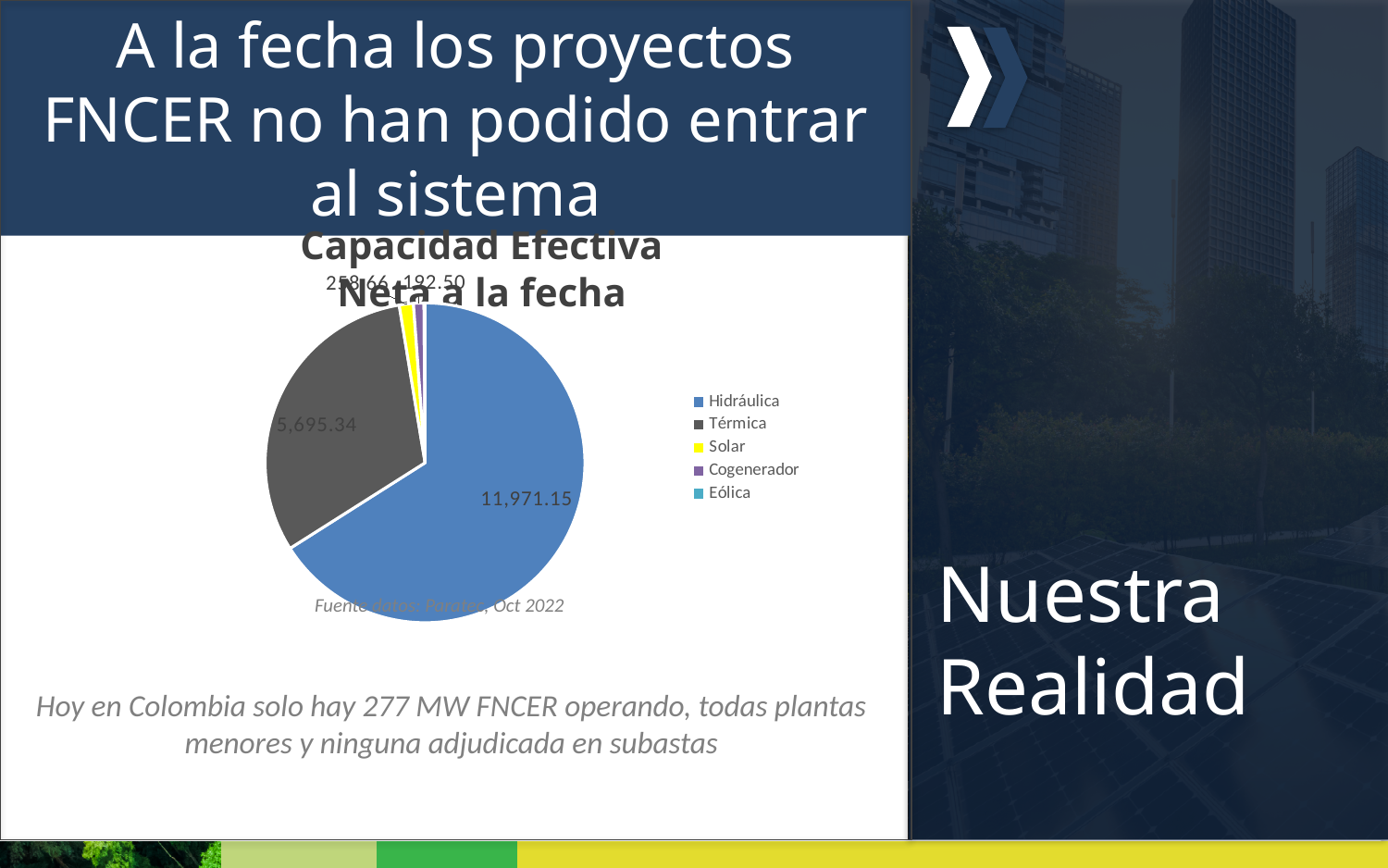
Which is larger in the pie chart, Hidráulica or Térmica? Hidráulica Which category has the largest slice in the pie chart? Hidráulica What is the title of the pie chart? Capacidad Efectiva Neta a la fecha Is the value for Hidráulica in the pie chart greater or less than 10,000? greater What kind of chart is shown on the slide? pie chart Which is larger in the pie chart, Solar or Térmica? Térmica What is the difference between the Hidráulica and Térmica values in the pie chart? 6,275.81 How many categories does the legend of the pie chart list? 5 Which colour represents Térmica in the pie chart? dark gray What is the value shown for Térmica in the pie chart? 5,695.34 What is the value shown for Hidráulica in the pie chart? 11,971.15